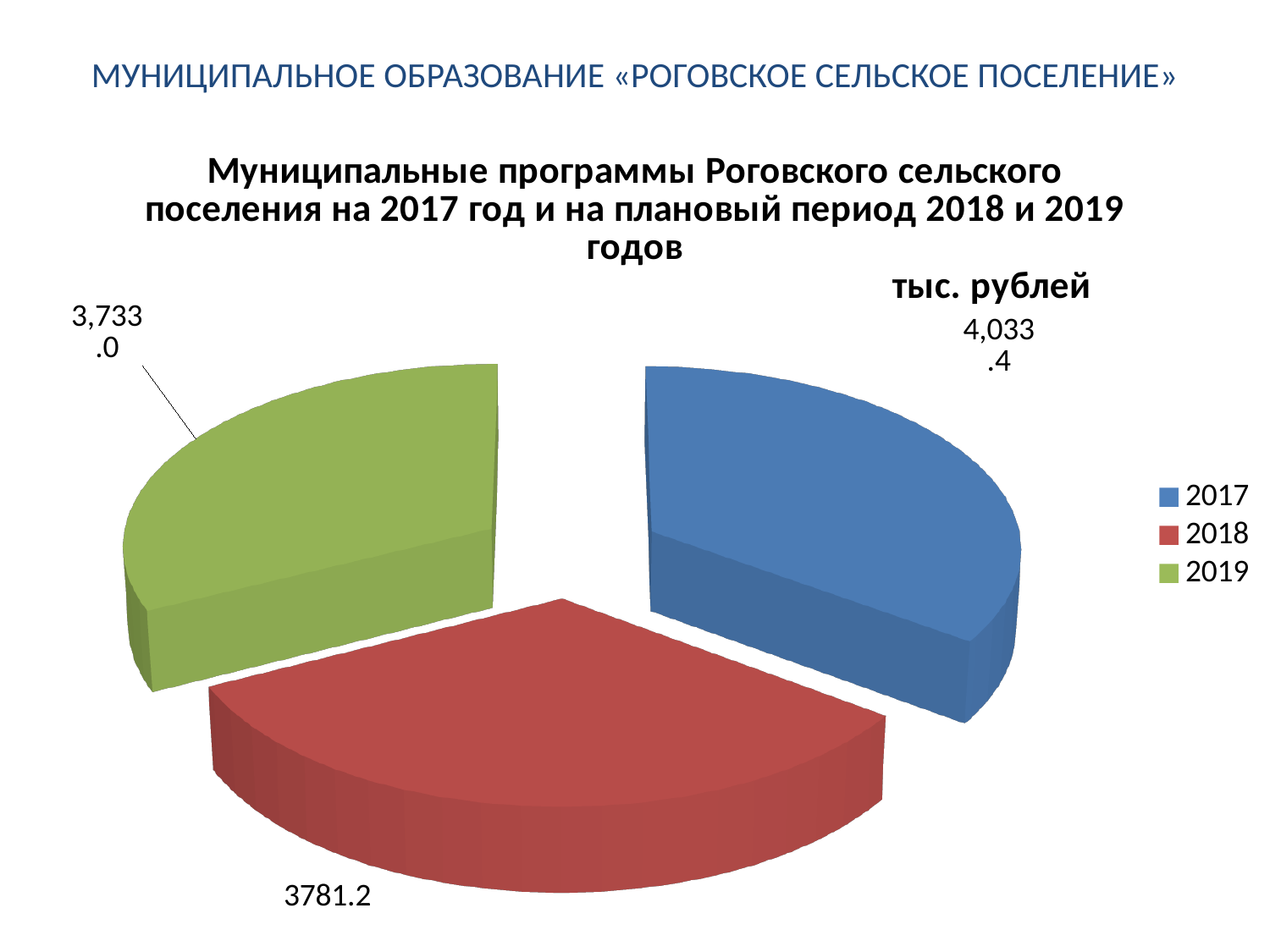
What type of chart is shown on the slide? Pie chart How many slices does the pie chart have? 3 What is the difference between the values for 2017 and 2018? 252.2 In what units are the values in the chart given? тыс. рублей What is the difference between the values for 2018 and 2019? 48.2 What is the value for 2017 in the pie chart? 4,033.4 What is the value for 2018 in the pie chart? 3781.2 What is the value for 2019 in the pie chart? 3,733.0 Which year has the largest slice in the pie chart? 2017 How many entries does the legend list? 3 Which is larger, the value for 2018 or the value for 2019? 2018 Which year has the smallest slice in the pie chart? 2019